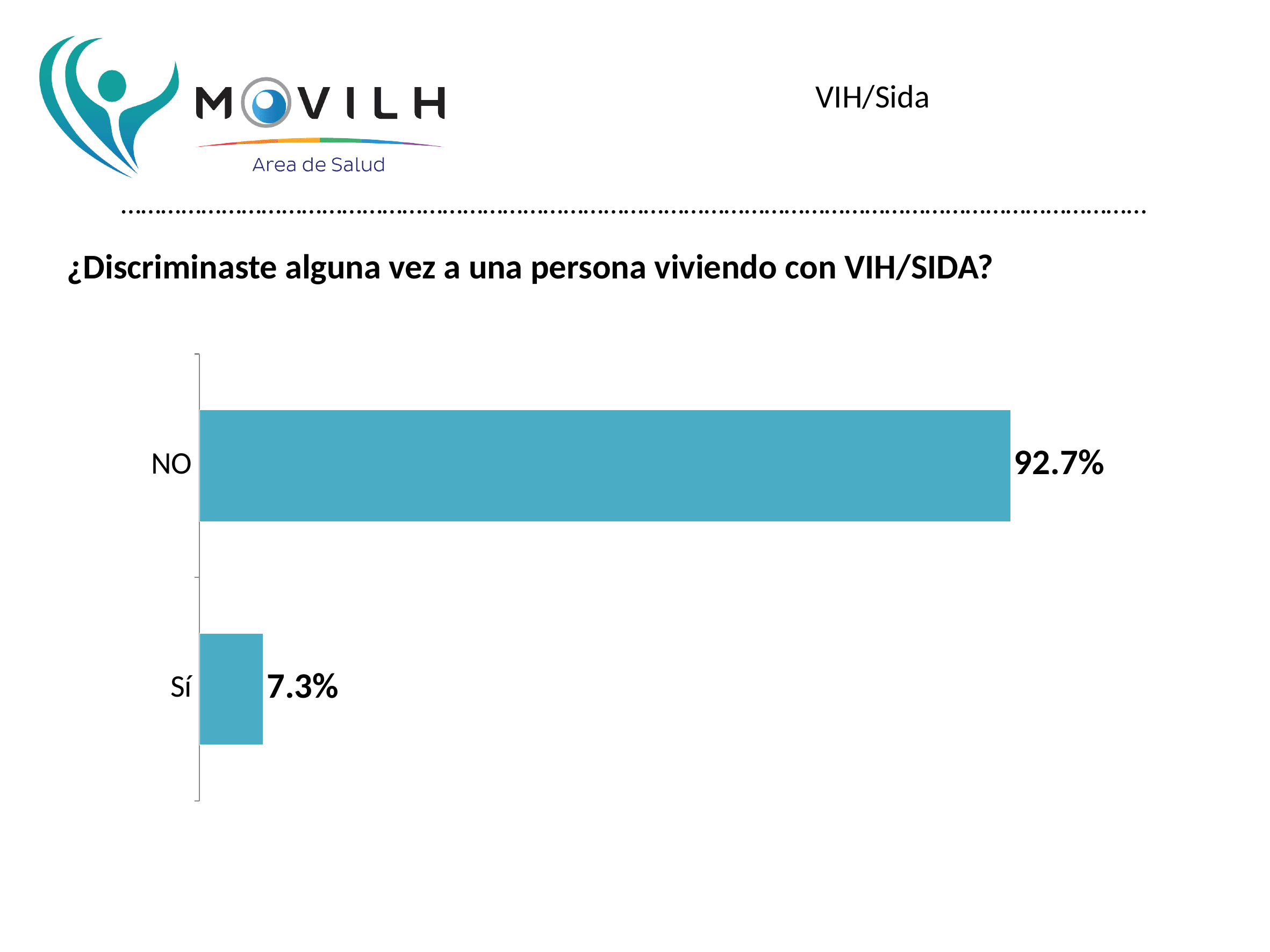
What colour are the bars in the chart? Blue Which category has the highest value? NO What kind of chart is shown on the slide? Bar chart Which category has the lowest value? Sí What is the value for NO? 92.7% How many categories are shown in the chart? 2 What is the difference between the values for NO and Sí? 85.4% What is the total of the two values shown in the chart? 100% What question does the chart title ask? ¿Discriminaste alguna vez a una persona viviendo con VIH/SIDA? Which is larger, the value for NO or the value for Sí? NO What is the value for Sí? 7.3%